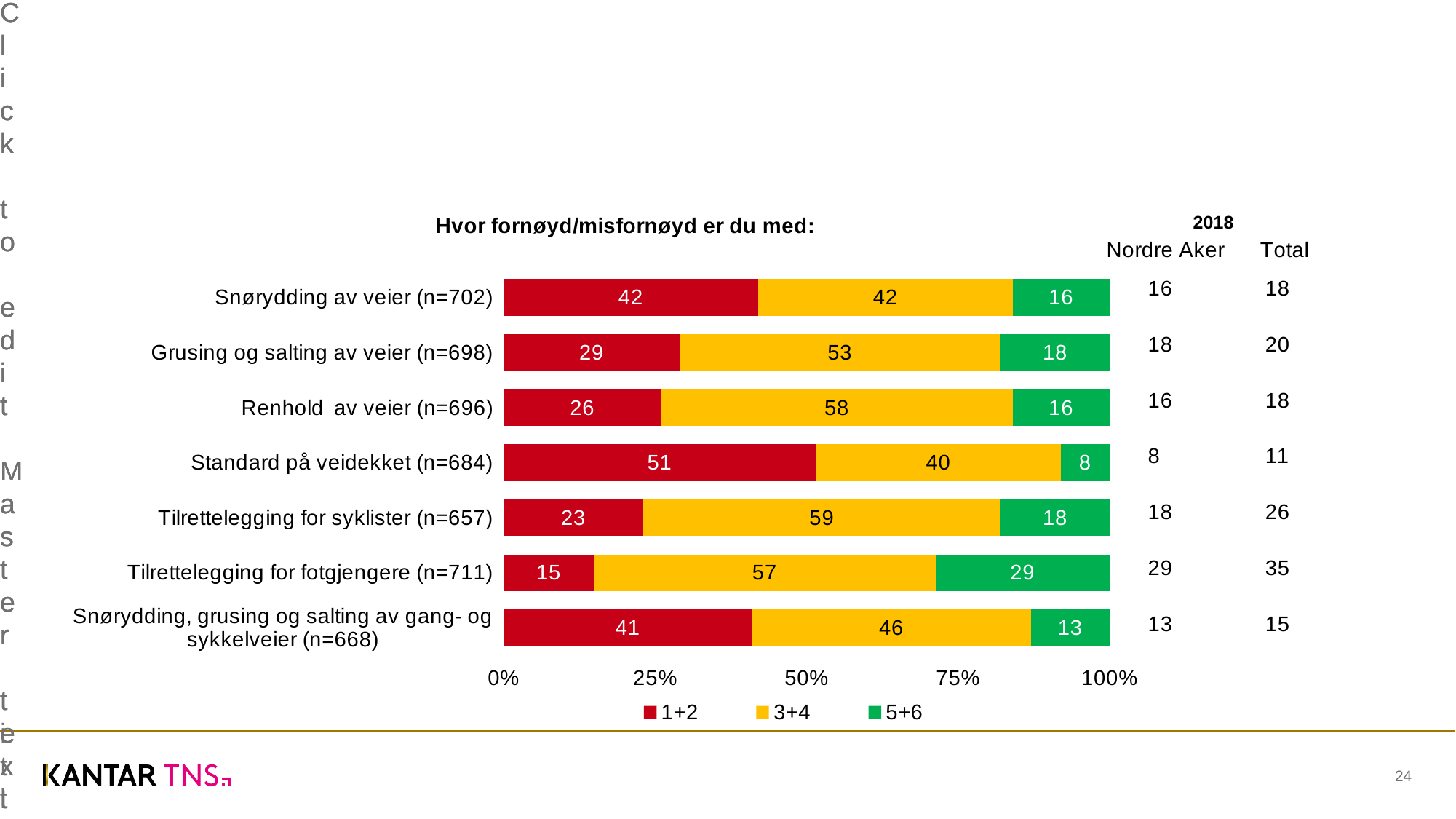
How many categories are shown in the chart? 7 What kind of chart is shown on the slide? Stacked bar chart What is the value of the 1+2 series for Standard på veidekket (n=684)? 51 How many series does the legend list? 3 What is the value of the 5+6 series for Tilrettelegging for fotgjengere (n=711)? 29 Which category has the lowest value in the 5+6 series? Standard på veidekket (n=684) What is the title of the chart? Hvor fornøyd/misfornøyd er du med: Which category has the highest value in the 1+2 series? Standard på veidekket (n=684) What is the difference between the 3+4 value for Tilrettelegging for syklister (n=657) and the 3+4 value for Snørydding av veier (n=702)? 17 Which category has the highest value in the 5+6 series? Tilrettelegging for fotgjengere (n=711) What is the value of the 3+4 series for Renhold av veier (n=696)? 58 Which has a larger 1+2 value: Snørydding av veier (n=702) or Grusing og salting av veier (n=698)? Snørydding av veier (n=702)